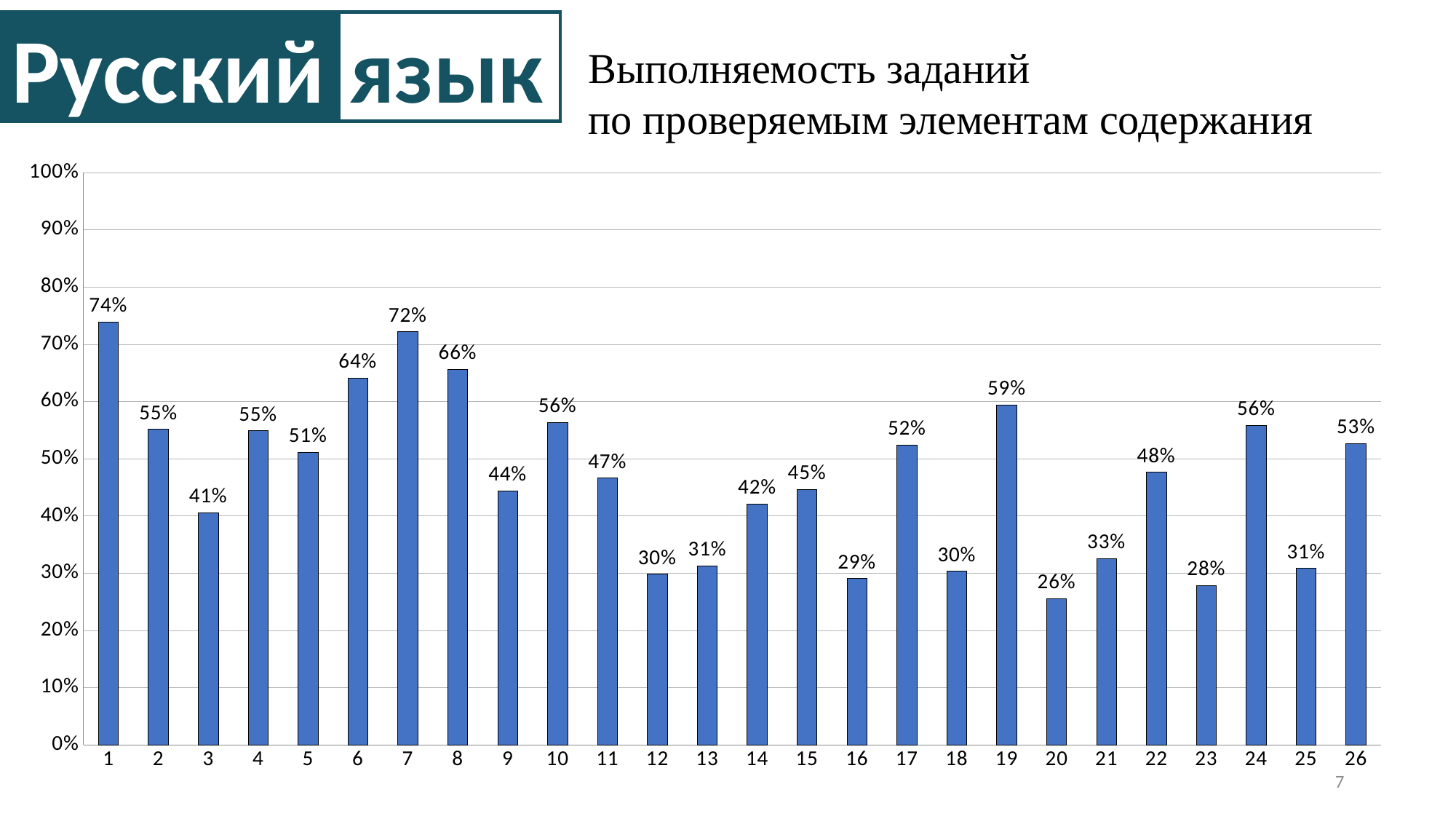
Is the value for task 8 greater or less than 60%? greater How many tasks are shown on the x axis? 26 What is the title of the chart? Выполняемость заданий по проверяемым элементам содержания What kind of chart is shown on the slide? bar chart Which task has the highest value? 1 Which task has the lowest value? 20 What is the value for task 14? 42% What is the difference between the values for task 1 and task 20? 48% What is the difference between the values for task 6 and task 9? 20% Which is larger, the value for task 17 or the value for task 22? task 17 What is the value for task 7? 72% What is the value for task 19? 59%